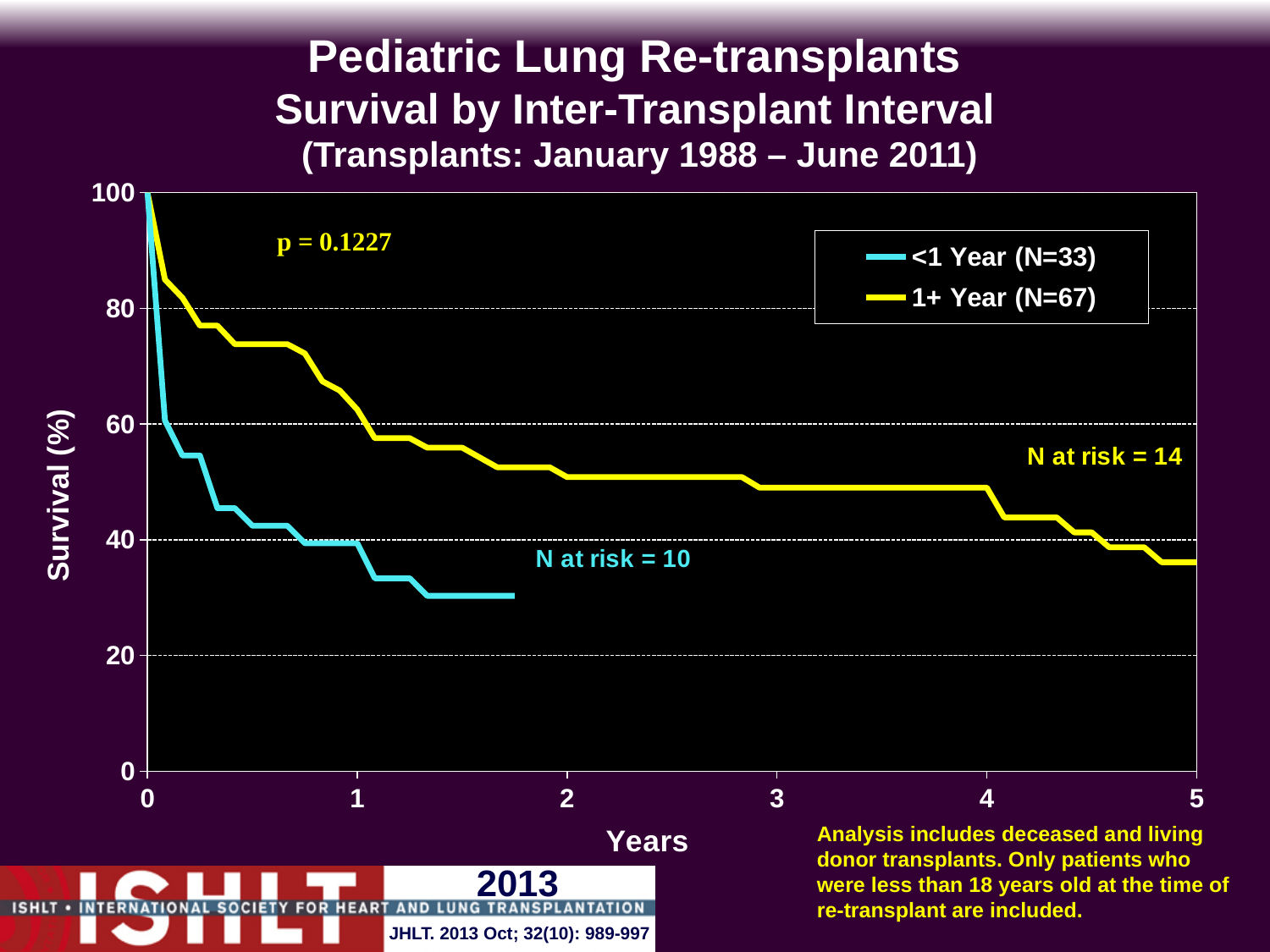
How many patients (N) are in the 1+ Year group according to the legend? 67 What is the N at risk shown for the 1+ Year group? 14 What is the N at risk shown for the <1 Year group? 10 Is the survival for the 1+ Year group at 3 years greater or less than 60? less What are the two series named in the legend? <1 Year (N=33) and 1+ Year (N=67) How many series does the legend list? 2 Is the survival for the <1 Year group at 1.5 years greater or less than 40? less At 1 year, which group has the higher survival, <1 Year or 1+ Year? 1+ Year What p-value is printed on the chart? p = 0.1227 What kind of chart is shown on the slide? line chart Do the survival curves rise or fall as years increase? fall Is the survival for the 1+ Year group at 2 years greater or less than 40? greater